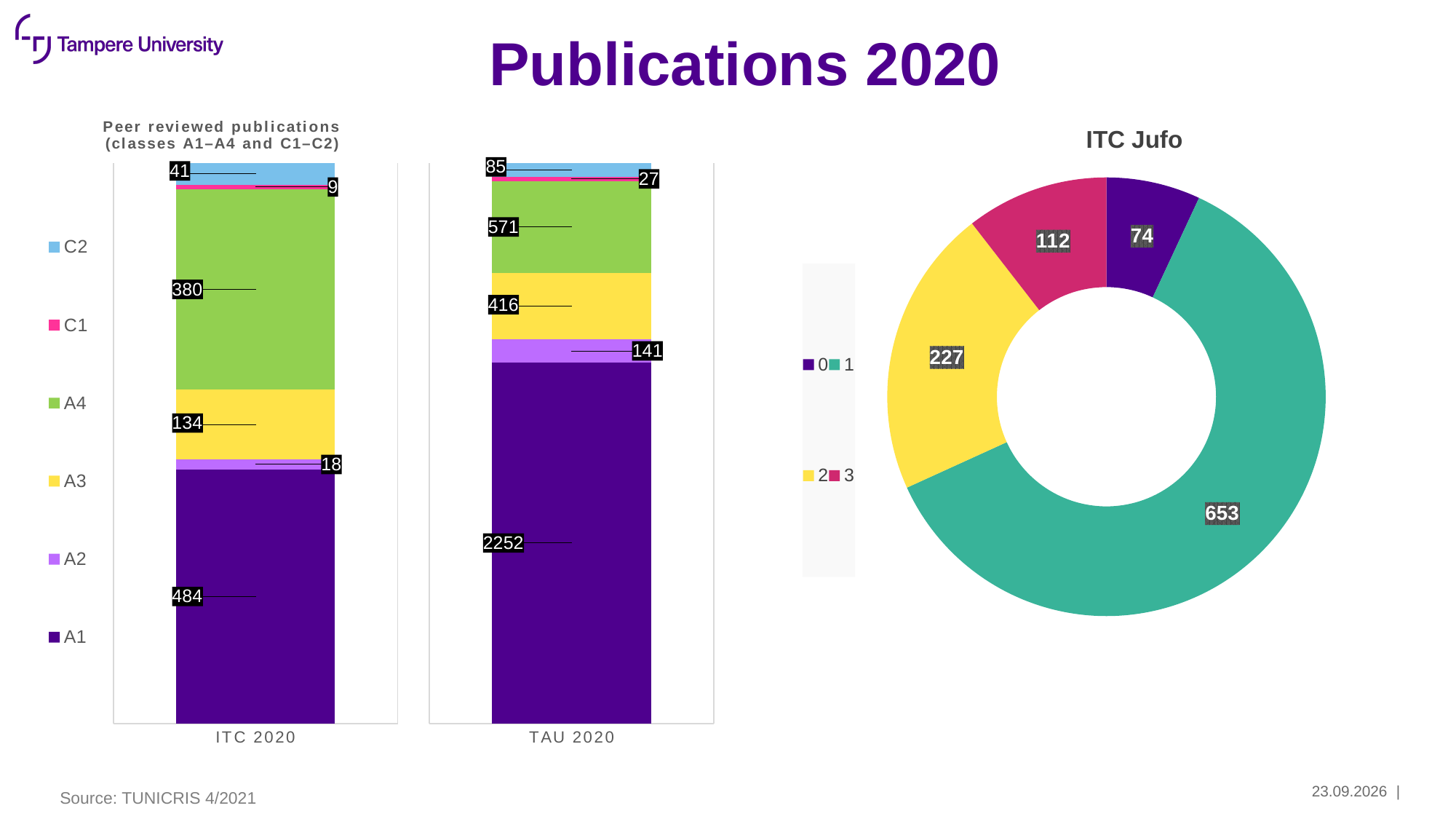
What is the difference between the A4 values in the TAU 2020 and ITC 2020 stacked bar charts? 191 In the ITC Jufo donut chart, which category has the largest value? 1 In the ITC 2020 stacked bar chart, what is the value for A1? 484 In the TAU 2020 stacked bar chart, which class has the smallest value? C1 In the ITC 2020 stacked bar chart, which class has the largest value? A1 What is the total of the TAU 2020 stacked bar? 3492 How many series does the legend of the ITC Jufo donut chart list? 4 What type of chart is the ITC Jufo chart? Donut chart What is the total of the ITC 2020 stacked bar? 1066 In the ITC Jufo donut chart, what is the value for category 2? 227 In the TAU 2020 stacked bar chart, what is the value for A4? 571 In the ITC 2020 stacked bar chart, which is larger, A3 or C2? A3